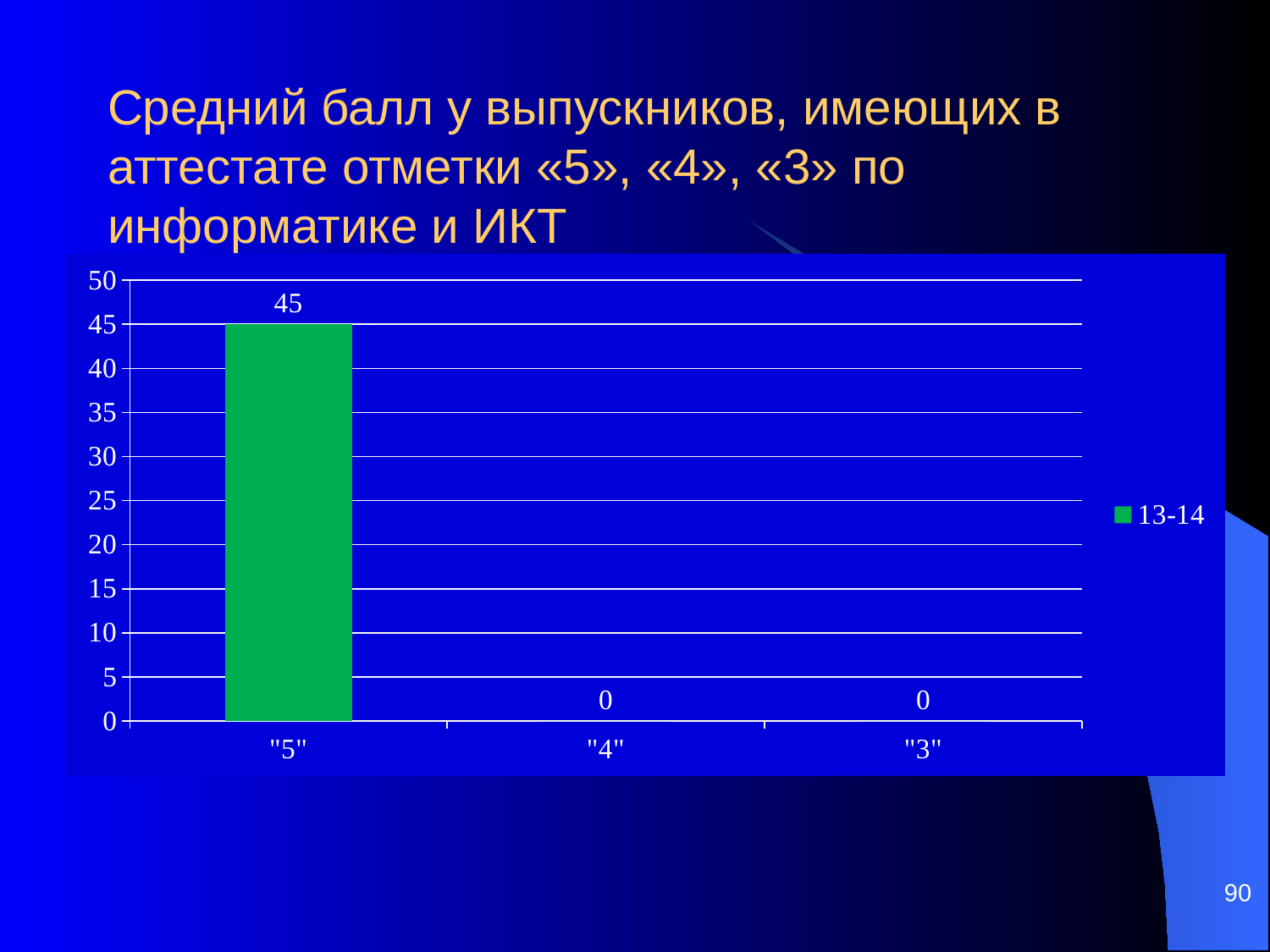
What is the value for the "4" category? 0 How many series does the legend list? 1 What is the value for the "5" category? 45 What is the value for the "3" category? 0 Which is larger, the value for "5" or the value for "3"? "5" What is the name of the series in the legend? 13-14 What kind of chart is shown on the slide? bar chart What is the maximum value shown on the vertical axis? 50 Which category has the highest value? "5" What is the difference between the values for "5" and "4"? 45 How many categories are shown on the x axis? 3 Is the value for "5" greater or less than 40? greater